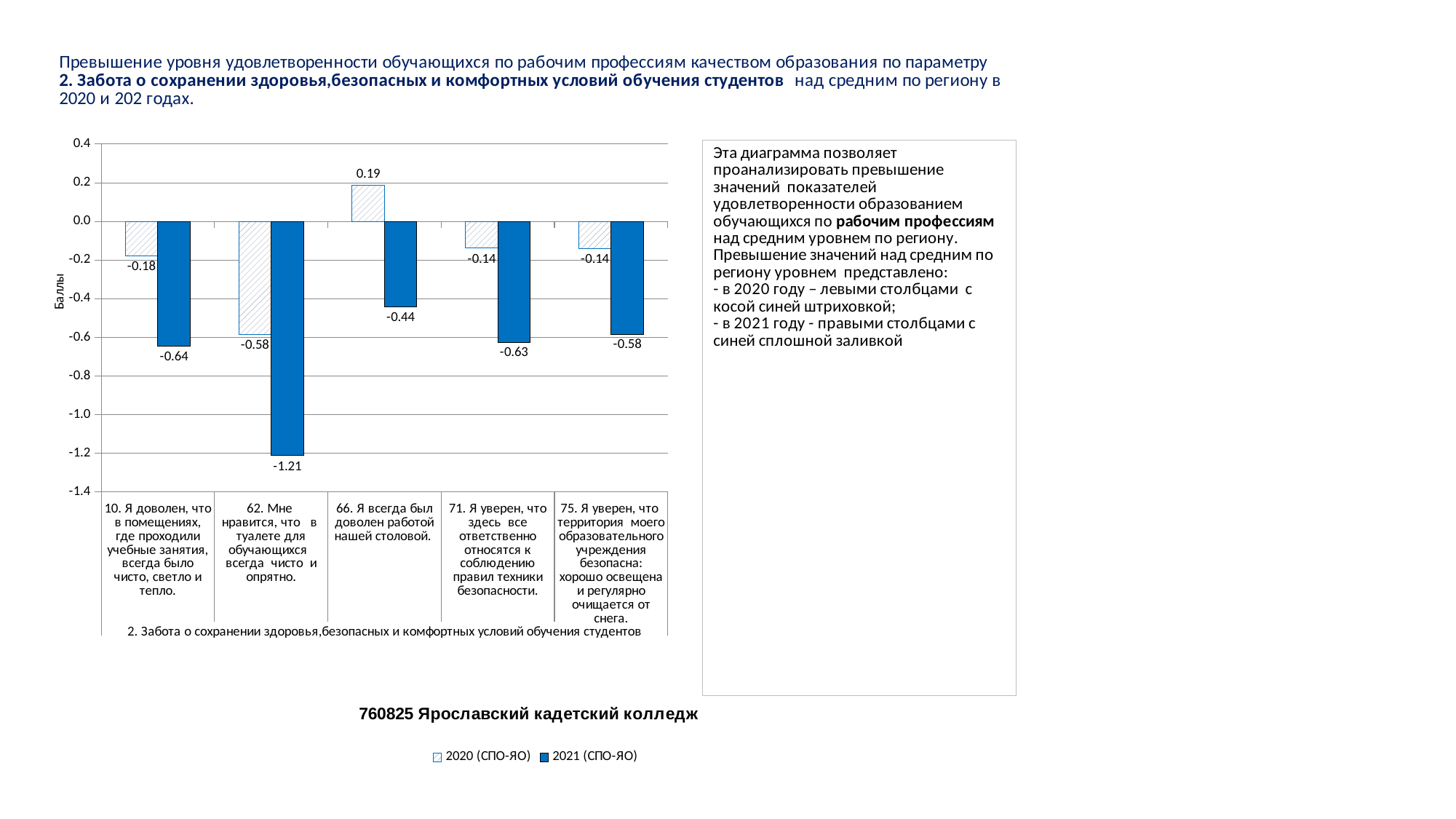
What is the difference between the 2020 (СПО-ЯО) and 2021 (СПО-ЯО) values for category 62? 0.63 What is the value for 2021 (СПО-ЯО) for category 62 (Мне нравится, что в туалете для обучающихся всегда чисто и опрятно)? -1.21 What type of chart is shown on the slide? bar chart What is the value for 2021 (СПО-ЯО) for category 10 (Я доволен, что в помещениях, где проходили учебные занятия, всегда было чисто, светло и тепло)? -0.64 What is the label of the y axis? Баллы How many series does the legend list? 2 What is the value for 2020 (СПО-ЯО) for category 66 (Я всегда был доволен работой нашей столовой)? 0.19 How many categories (questions) are shown on the x axis? 5 Which category has the lowest value for the 2021 (СПО-ЯО) series? 62. Мне нравится, что в туалете для обучающихся всегда чисто и опрятно. What is the value for 2021 (СПО-ЯО) for category 75 (Я уверен, что территория моего образовательного учреждения безопасна)? -0.58 Which category has the highest value for the 2020 (СПО-ЯО) series? 66. Я всегда был доволен работой нашей столовой. Which is larger for category 71: the 2020 (СПО-ЯО) value or the 2021 (СПО-ЯО) value? 2020 (СПО-ЯО)